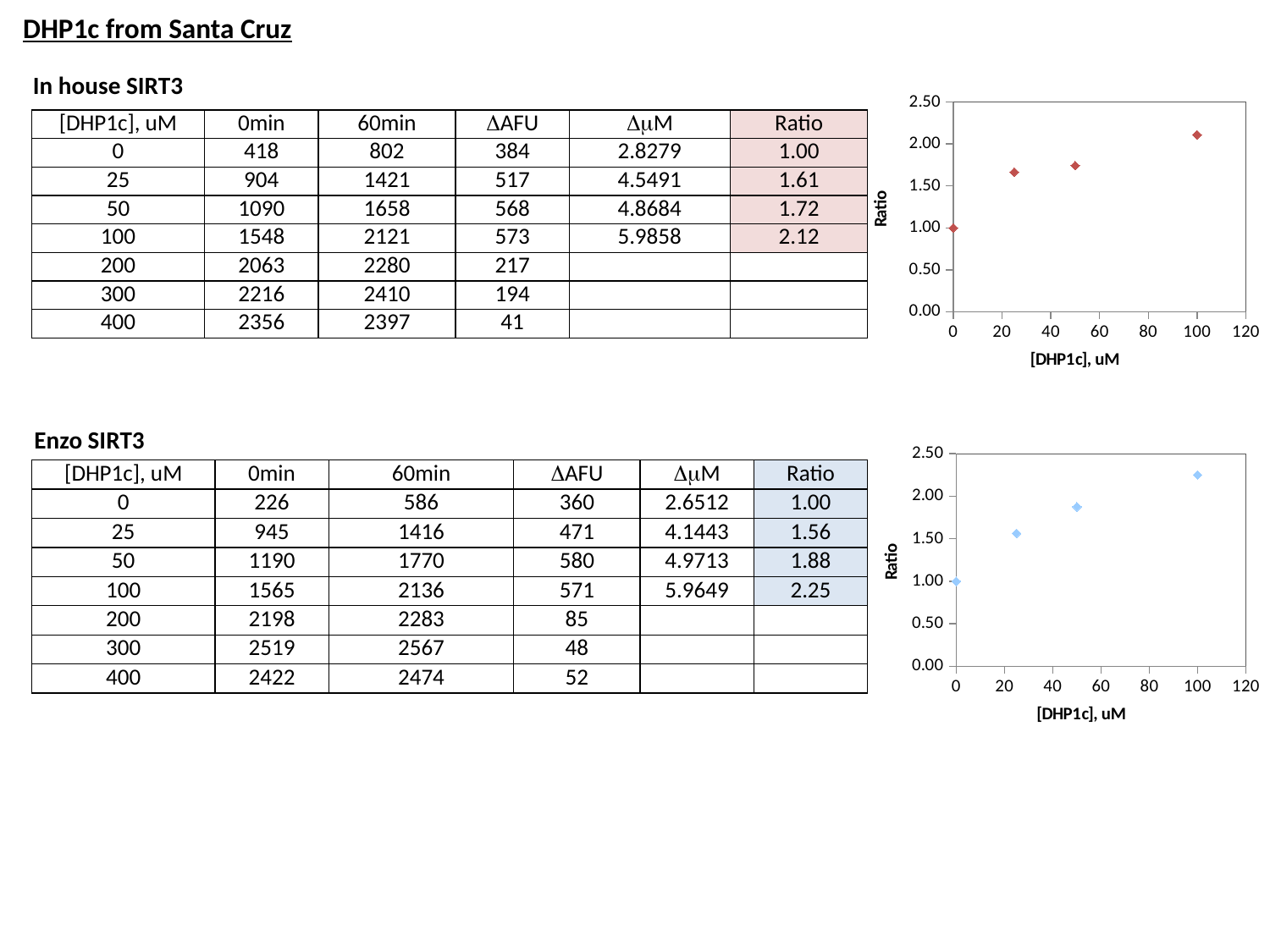
How many data points are plotted in the top chart (In house SIRT3)? 4 In the bottom chart (Enzo SIRT3), at which [DHP1c] concentration is the Ratio lowest? 0 What is the y-axis title of the top chart (In house SIRT3)? Ratio In the bottom chart (Enzo SIRT3), is the Ratio at 25 uM greater or less than 2.00? less In the top chart (In house SIRT3), do the Ratio values rise or fall as [DHP1c] increases? rise In the top chart (In house SIRT3), at which [DHP1c] concentration is the Ratio highest? 100 In the top chart (In house SIRT3), is the Ratio at 100 uM greater or less than 2.00? greater In the top chart (In house SIRT3), what is the Ratio at 0 uM [DHP1c]? 1.00 In the bottom chart (Enzo SIRT3), which has the larger Ratio: 25 uM or 50 uM? 50 uM What kind of chart is the top chart (In house SIRT3)? scatter chart In the bottom chart (Enzo SIRT3), what is the Ratio at 100 uM [DHP1c]? 2.25 How many data points are plotted in the bottom chart (Enzo SIRT3)? 4